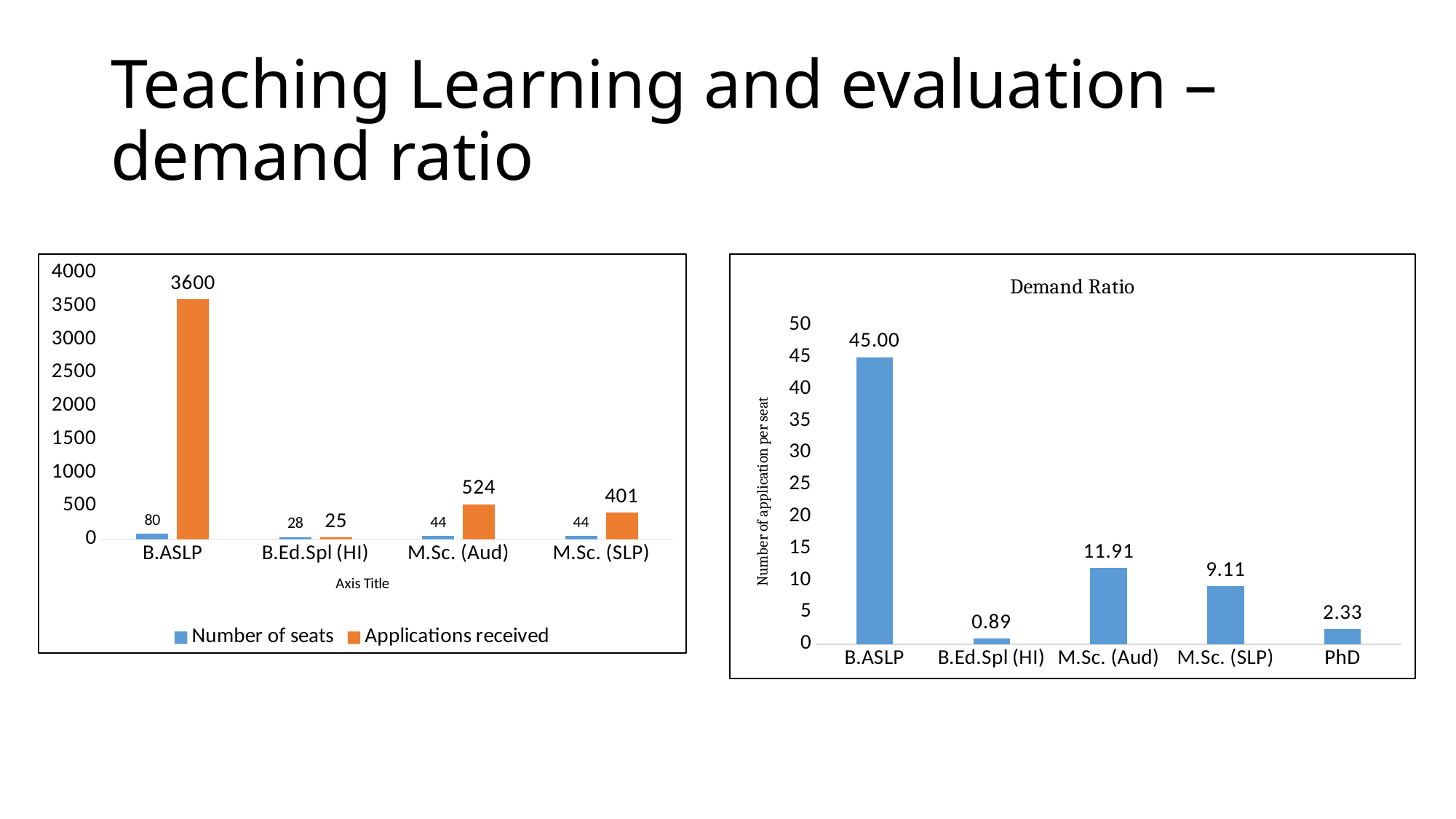
In the left chart, how many applications were received for B.ASLP? 3600 In the left chart, what is the difference between applications received for M.Sc. (Aud) and M.Sc. (SLP)? 123 What type of chart is the Demand Ratio chart? Bar chart In the Demand Ratio chart, how many categories are shown? 5 In the left chart, how many series does the legend list? 2 In the left chart, which category has the highest number of applications received? B.ASLP In the left chart, what is the number of seats for M.Sc. (Aud)? 44 In the Demand Ratio chart, what is the y-axis title? Number of application per seat In the left chart, which category has the lowest number of applications received? B.Ed.Spl (HI) In the Demand Ratio chart, which category has the highest demand ratio? B.ASLP In the left chart, which is larger for B.Ed.Spl (HI): number of seats or applications received? Number of seats In the Demand Ratio chart, what is the value for PhD? 2.33